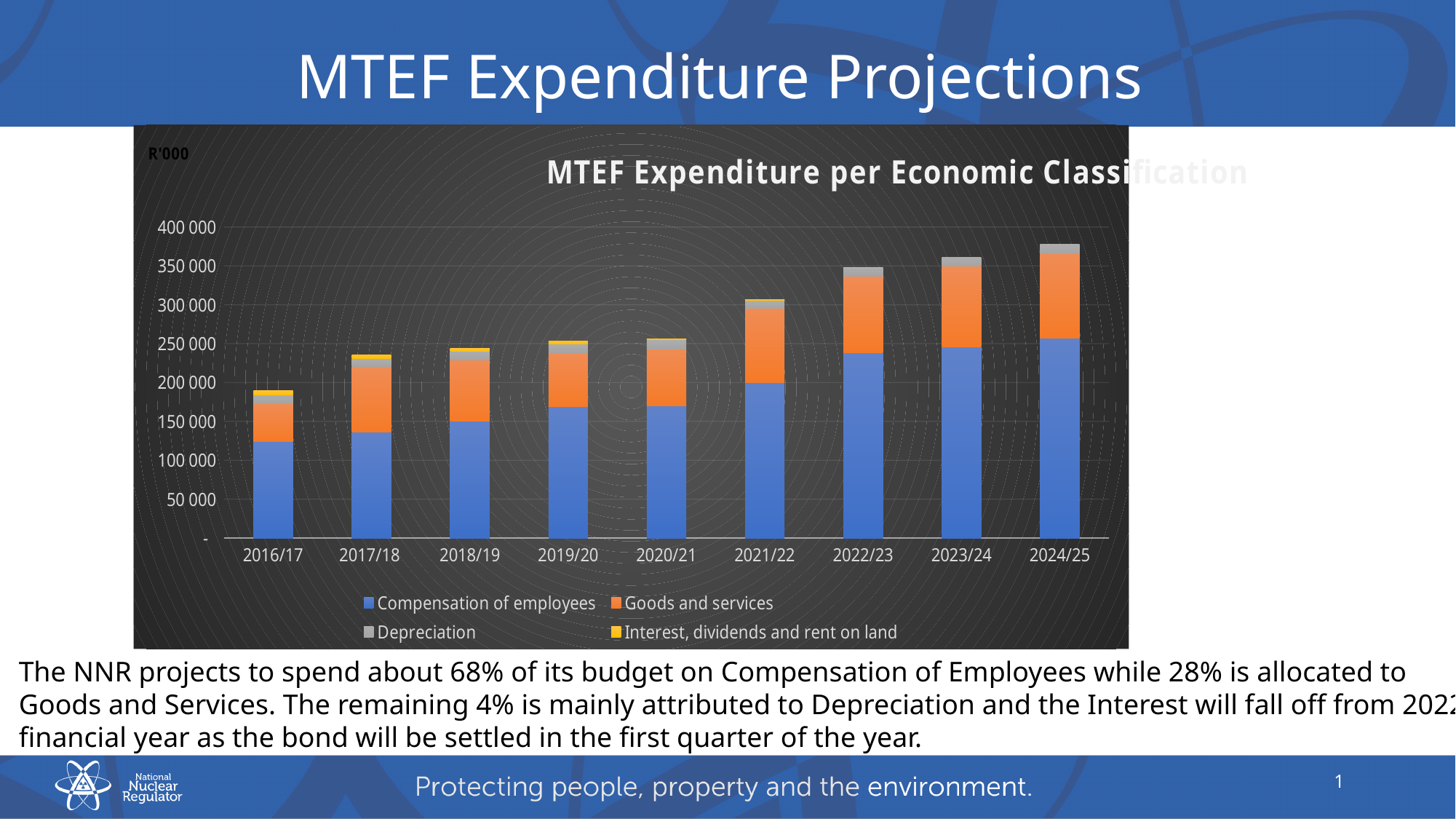
What kind of chart is shown on the slide? Stacked bar chart What unit is shown at the top of the chart's vertical axis? R'000 Which financial year has the lowest total expenditure in the chart? 2016/17 Which financial year has the highest total expenditure in the chart? 2024/25 Is the total expenditure for 2016/17 greater or less than 200 000? less How many series does the chart's legend list? 4 Is the total expenditure for 2024/25 greater or less than 350 000? greater Is the Compensation of employees value for 2016/17 greater or less than 100 000? greater Does total expenditure generally rise or fall from 2016/17 to 2024/25? Rise How many financial years are shown on the x axis of the chart? 9 What is the title of the chart? MTEF Expenditure per Economic Classification